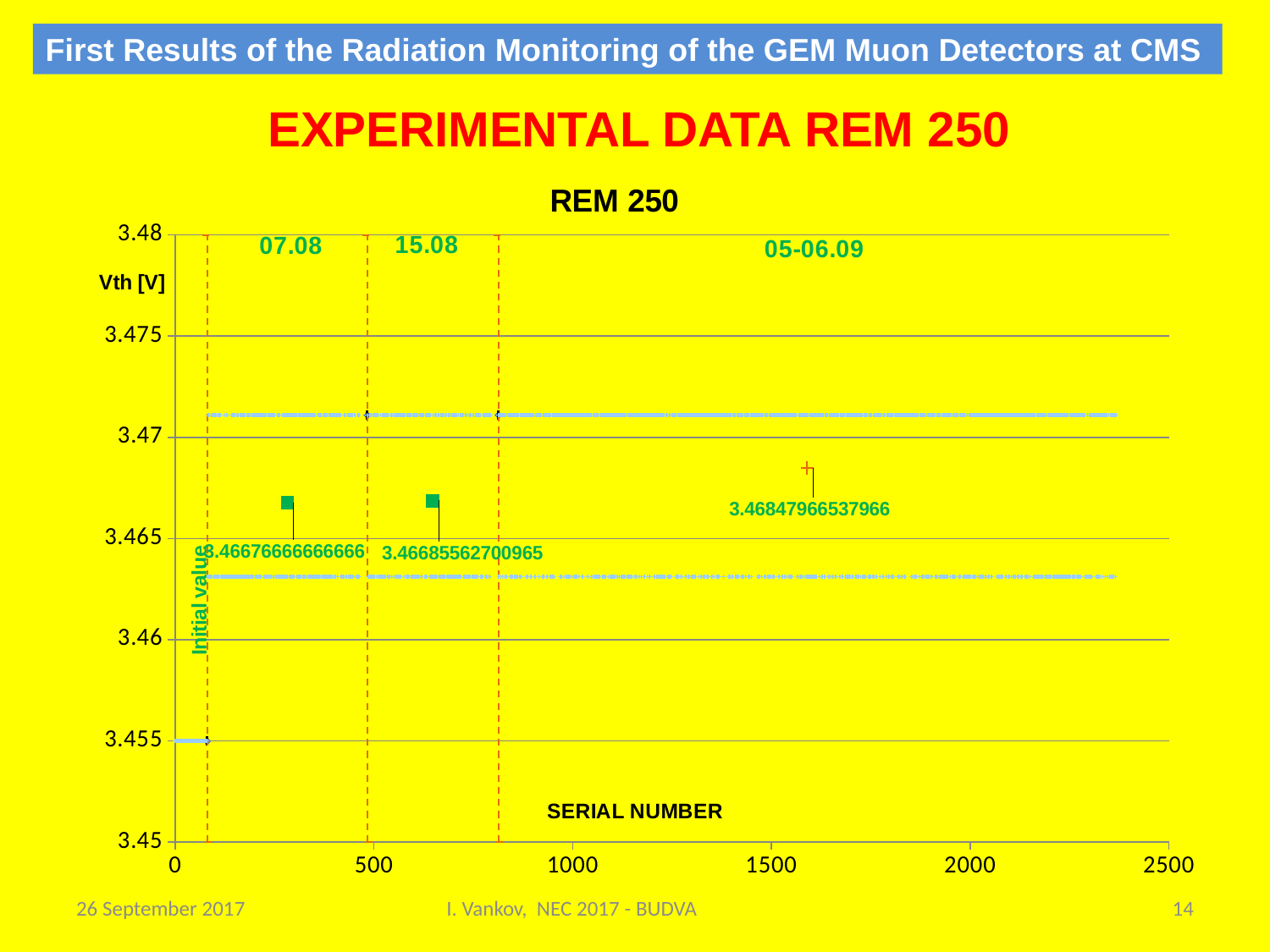
What is the difference between the Vth value for 05-06.09 and the Vth value for 07.08? 0.001712998713 What is the Vth value of the data point labelled 15.08? 3.46685562700965 What is the label of the x axis of the chart? SERIAL NUMBER Which labelled measurement date has the lowest Vth value? 07.08 What is the Vth value of the data point labelled 05-06.09? 3.46847966537966 How many labelled data points are plotted on the chart? 3 Do the labelled Vth values rise or fall as the serial number increases? rise What kind of chart is shown on the slide? scatter chart Which labelled measurement date has the highest Vth value? 05-06.09 Which has the larger Vth value, the 07.08 point or the 05-06.09 point? 05-06.09 What is the Vth value of the data point labelled 07.08? 3.46676666666666 Is the Vth value for the 05-06.09 point greater or less than 3.465? greater